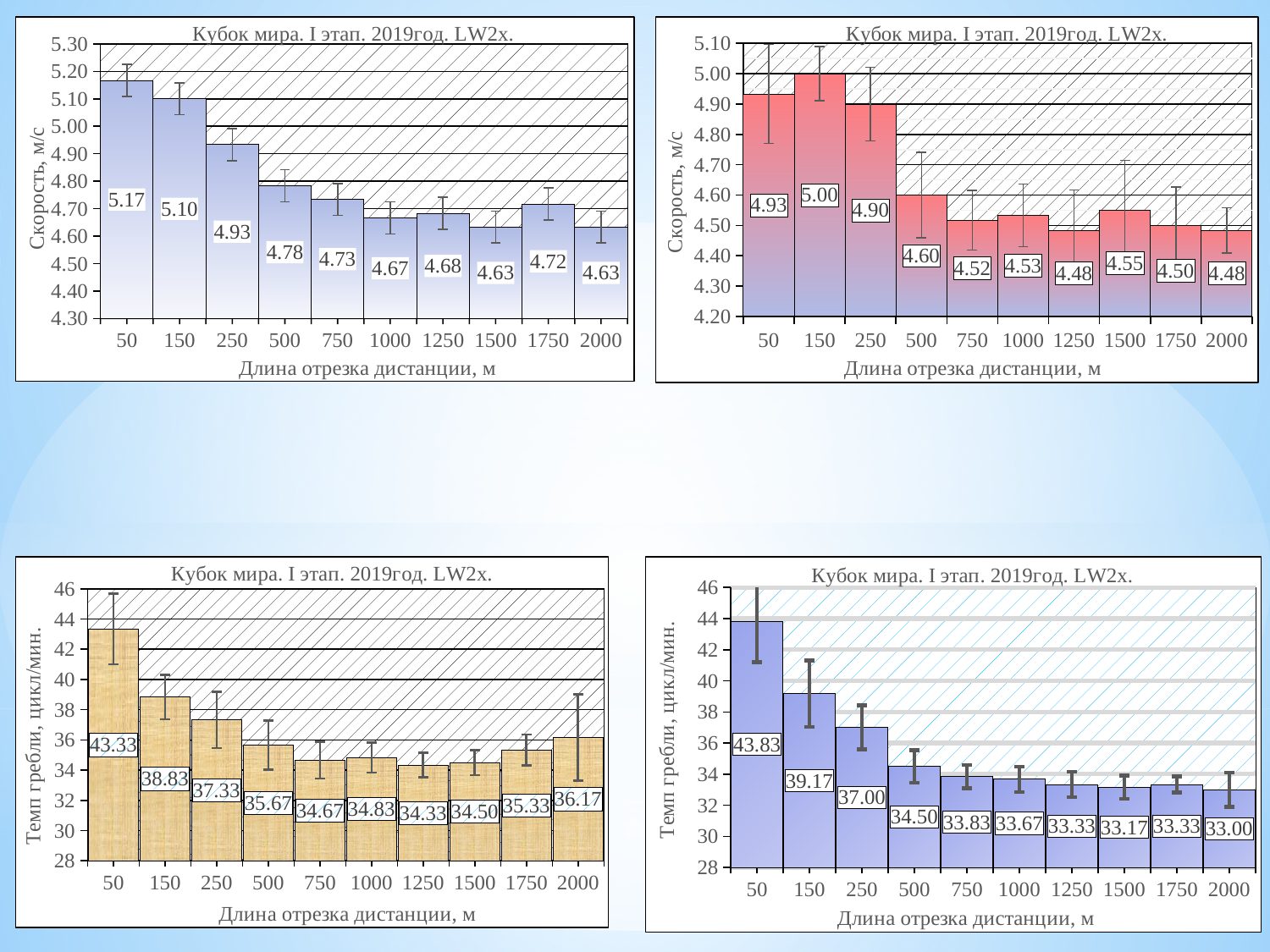
In the top-left chart, what is the difference between the values for 50 m and 2000 m? 0.54 In the bottom-right chart, which segment length has the lowest stroke rate? 2000 In the top-right chart, which segment length has the highest speed? 150 In the top-right chart, what is the speed value for the 500 m segment? 4.60 In the top-left chart, what is the speed value for the 50 m segment? 5.17 In the bottom-left chart, what is the stroke rate value for the 2000 m segment? 36.17 How many segment-length categories are shown on the x axis of the top-left chart? 10 In the bottom-left chart, which is larger: the value for 1750 m or the value for 1000 m? 1750 m What is the y-axis label of the bottom-left chart? Темп гребли, цикл/мин. What type of chart is the bottom-right chart? bar chart In the top-right chart, do the values generally rise or fall from 250 m to 1250 m? fall In the bottom-right chart, what is the difference between the values for 50 m and 150 m? 4.66